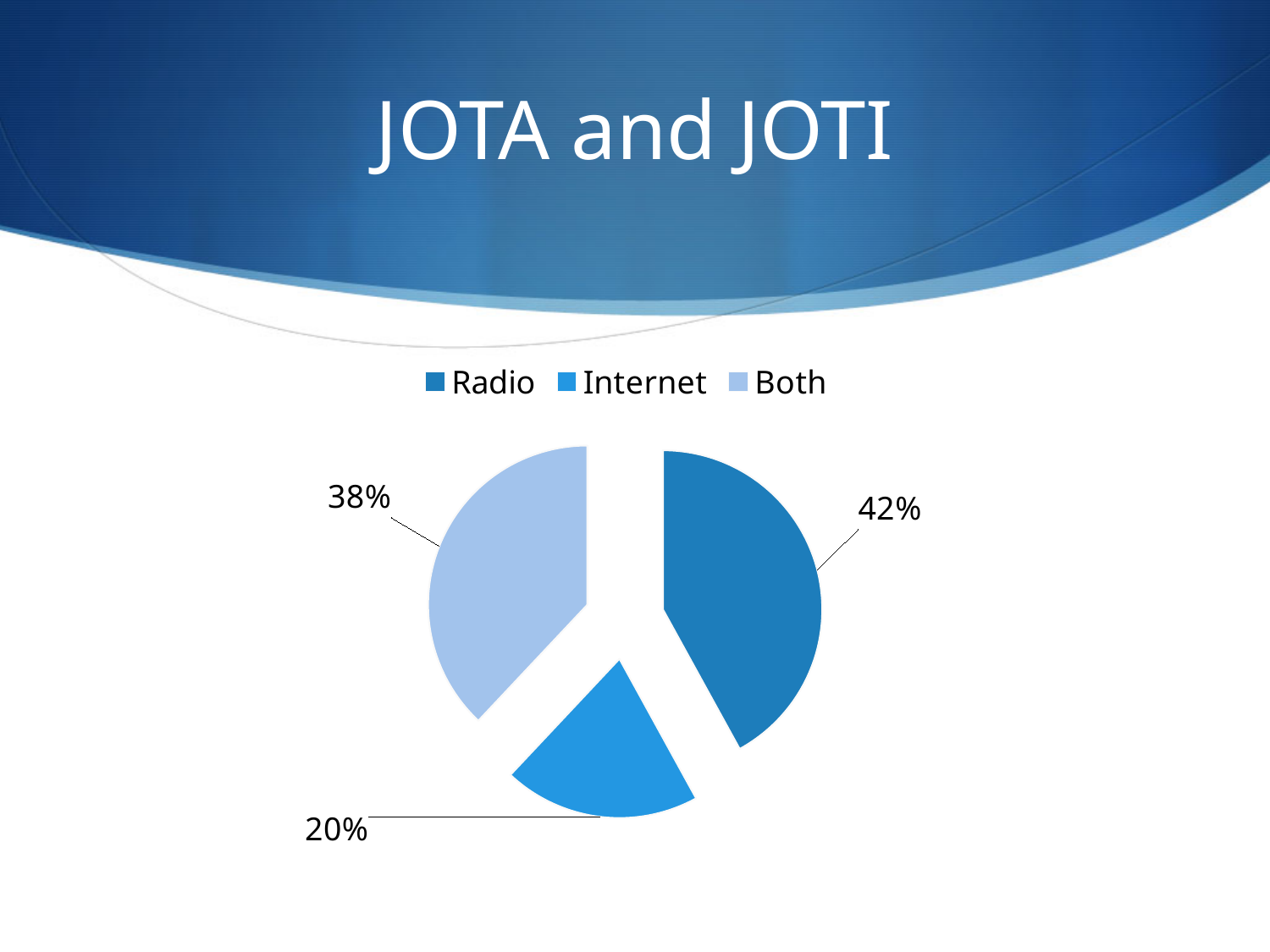
What percentage of the pie is Both? 38% Which is larger, the share for Both or the share for Internet? Both How many slices does the pie chart have? 3 Which category has the largest share of the pie? Radio What is the title of the slide containing the pie chart? JOTA and JOTI How many entries does the legend list? 3 What is the difference in percentage points between Radio and Both? 4 What is the difference in percentage points between Radio and Internet? 22 What percentage of the pie is Radio? 42% What kind of chart is shown on the slide? pie chart Which category has the smallest share of the pie? Internet What percentage of the pie is Internet? 20%